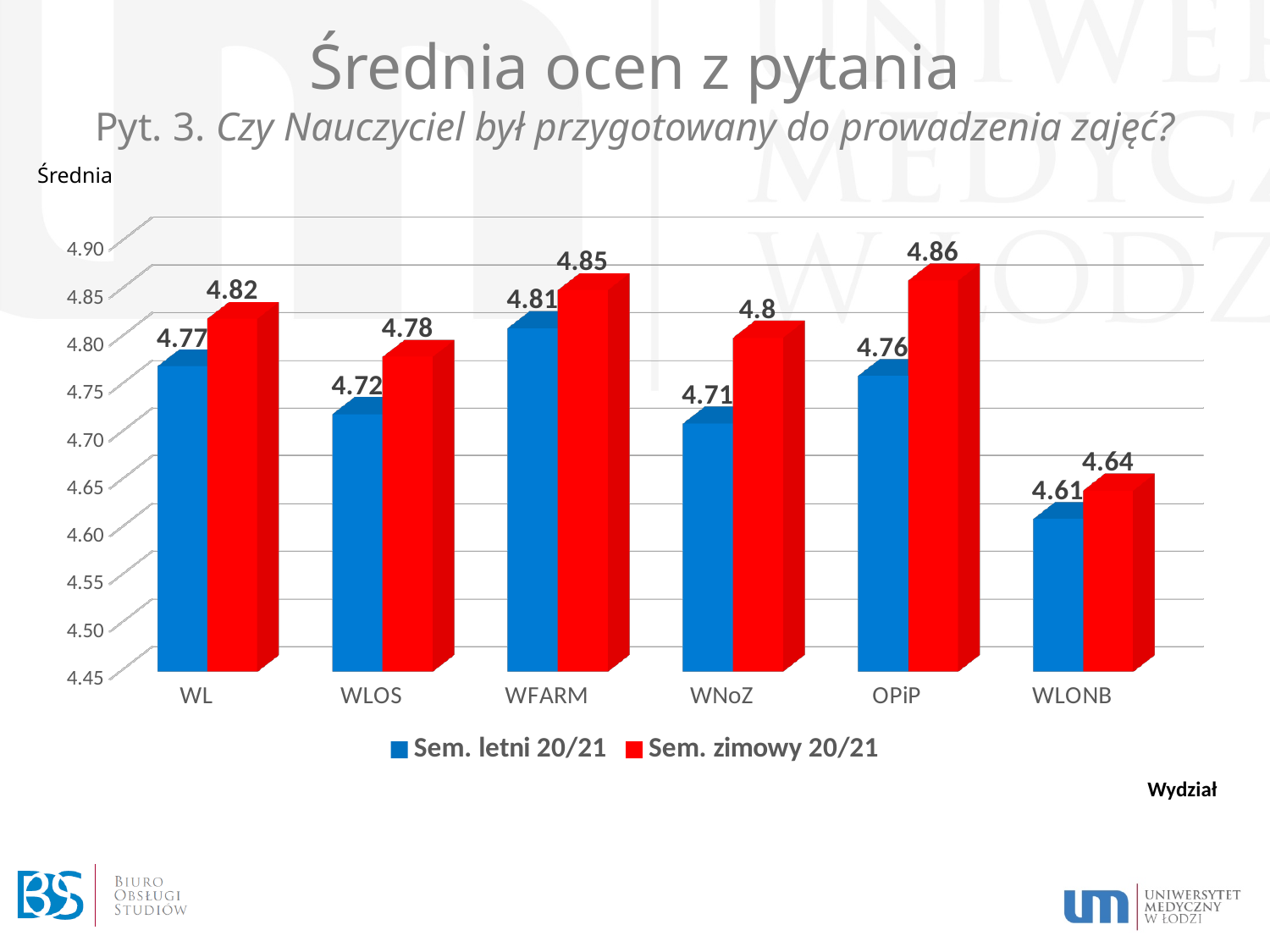
How many categories are shown on the x axis? 6 How many series does the legend list? 2 Which category has the lowest value in the Sem. letni 20/21 series? WLONB What is the value for OPiP in the Sem. zimowy 20/21 series? 4.86 What is the value for WNoZ in the Sem. zimowy 20/21 series? 4.8 Which category has the highest value in the Sem. zimowy 20/21 series? OPiP Is the Sem. letni 20/21 value for WLOS greater or less than 4.75? less What is the value for WL in the Sem. letni 20/21 series? 4.77 What colour represents the Sem. zimowy 20/21 series? red What is the difference between the Sem. zimowy 20/21 and Sem. letni 20/21 values for WNoZ? 0.09 Which is larger for WFARM: the Sem. letni 20/21 value or the Sem. zimowy 20/21 value? Sem. zimowy 20/21 What kind of chart is shown on the slide? bar chart